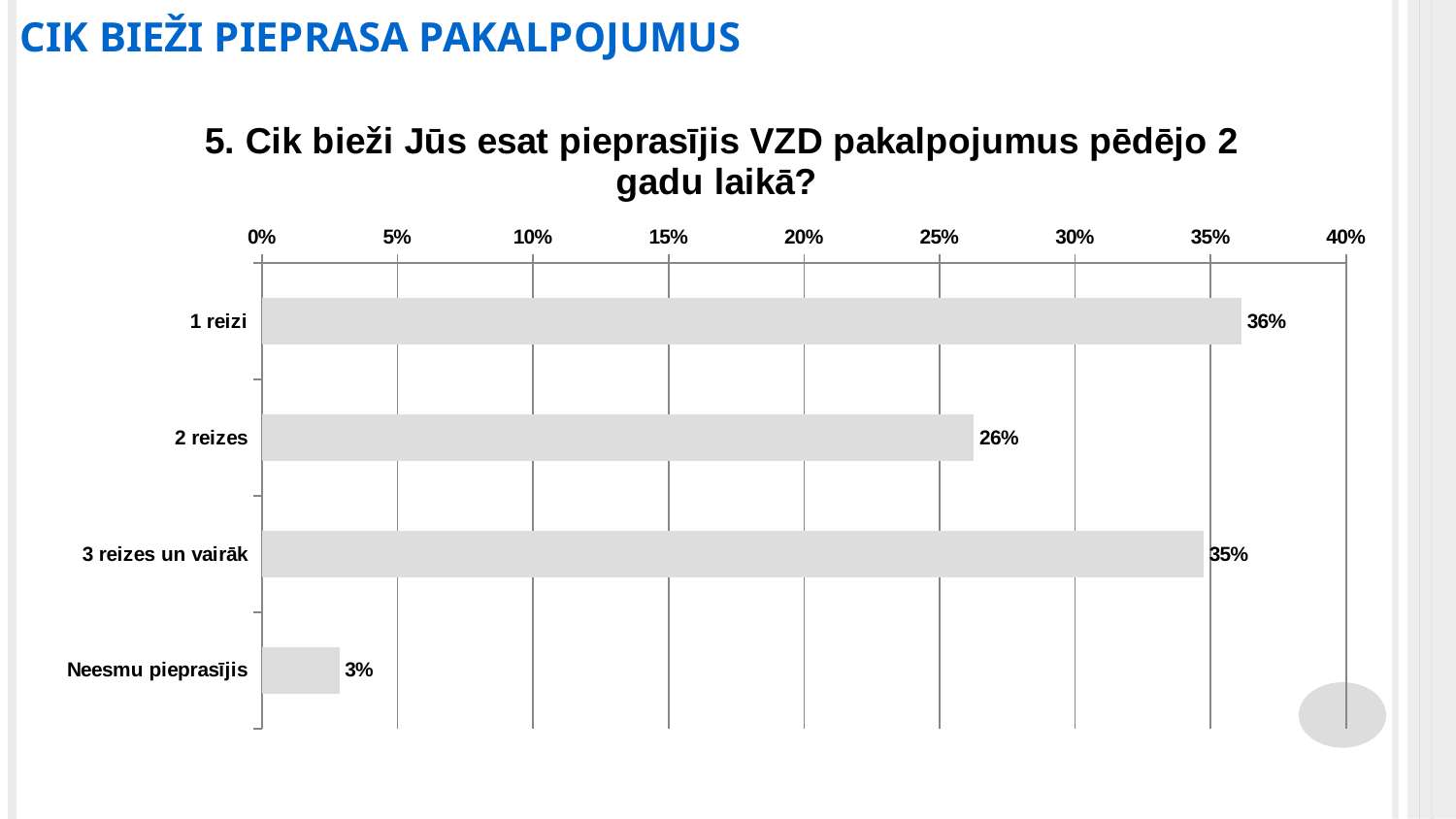
How many categories are shown in the chart? 4 What is the title of the chart? 5. Cik bieži Jūs esat pieprasījis VZD pakalpojumus pēdējo 2 gadu laikā? Which category has the lowest value? Neesmu pieprasījis Which is larger, the value for "2 reizes" or the value for "3 reizes un vairāk"? 3 reizes un vairāk What is the value for "1 reizi"? 36% What is the value for "Neesmu pieprasījis"? 3% What is the difference between the values for "1 reizi" and "2 reizes"? 10% What is the value for "2 reizes"? 26% What is the value for "3 reizes un vairāk"? 35% Which category has the highest value? 1 reizi What is the difference between the values for "3 reizes un vairāk" and "Neesmu pieprasījis"? 32% What kind of chart is shown on the slide? Bar chart